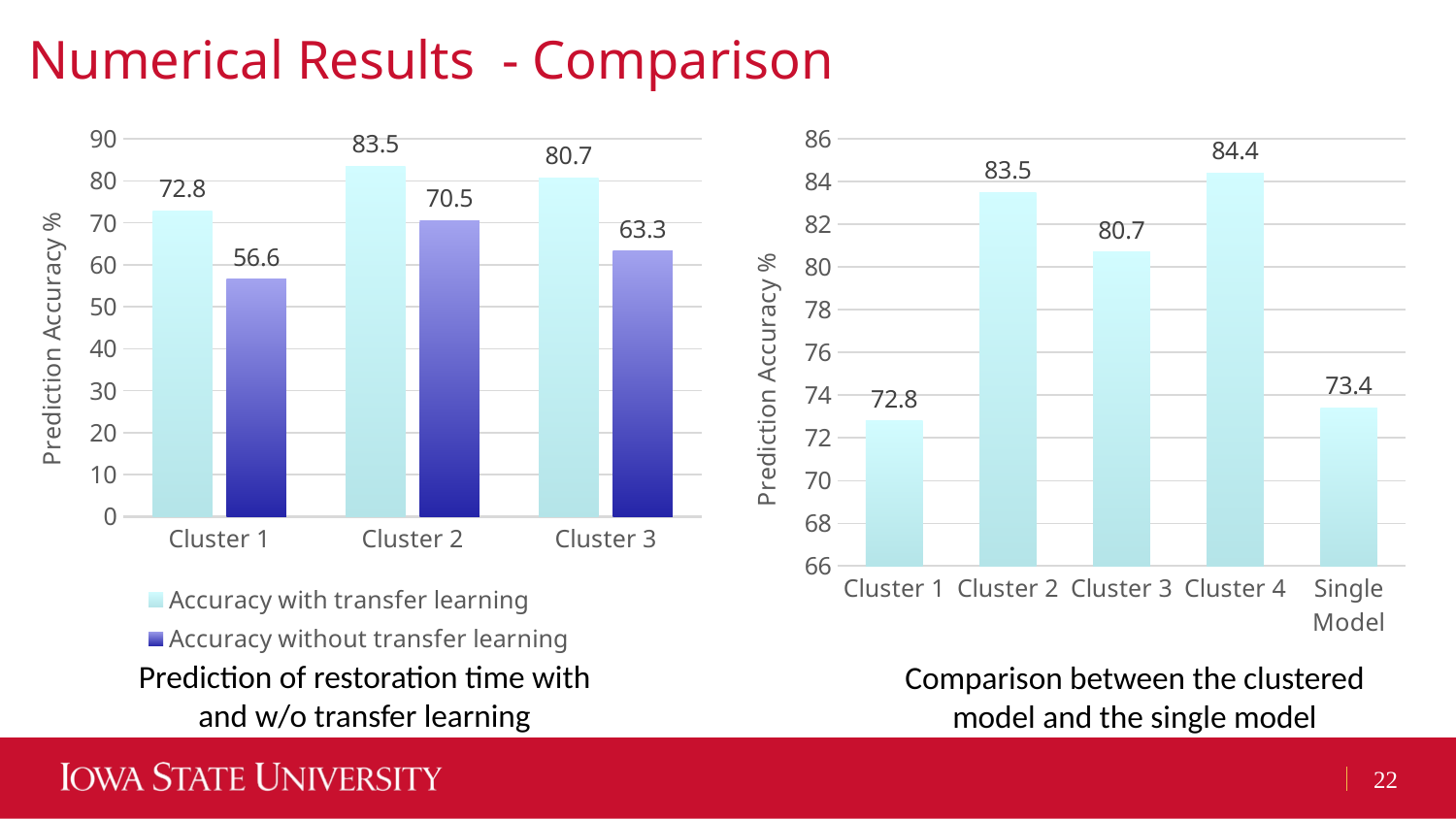
In the left chart, which cluster has the lowest accuracy without transfer learning? Cluster 1 In the left chart, what is the accuracy with transfer learning for Cluster 2? 83.5 In the right chart, what is the prediction accuracy for Cluster 4? 84.4 In the right chart, which category has the highest prediction accuracy? Cluster 4 In the left chart, what is the difference between accuracy with and without transfer learning for Cluster 3? 17.4 In the right chart, how many categories are shown on the x axis? 5 In the right chart, what is the prediction accuracy for the Single Model? 73.4 What kind of chart is the right chart? Bar chart In the left chart, what is the accuracy without transfer learning for Cluster 1? 56.6 In the left chart, how many series does the legend list? 2 In the left chart, which is larger for Cluster 2: accuracy with transfer learning or accuracy without transfer learning? Accuracy with transfer learning In the right chart, what is the difference in prediction accuracy between Cluster 4 and the Single Model? 11